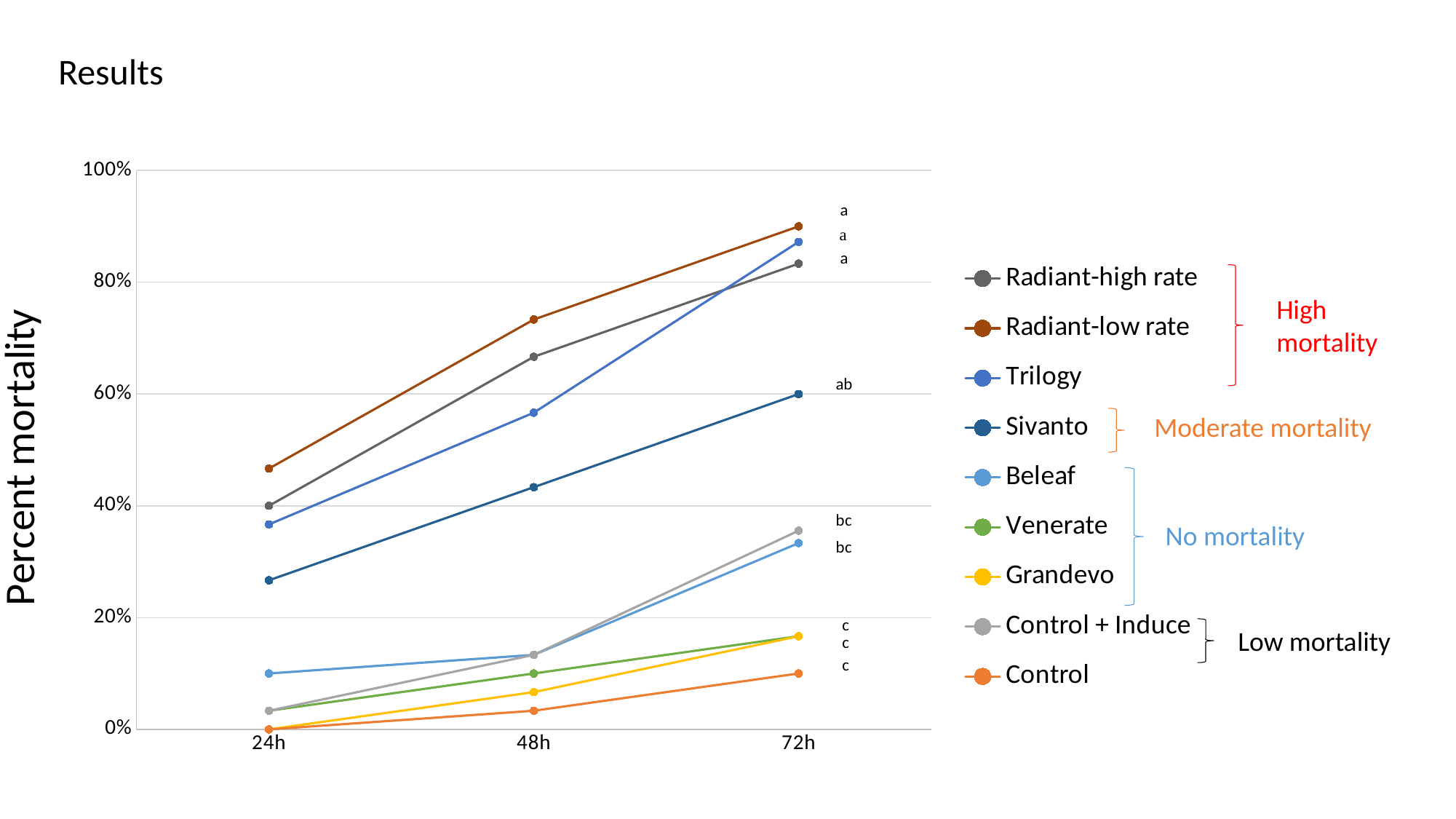
Is the value for Beleaf at 72h greater or less than 40%? less Which series has the lowest percent mortality at 72h? Control Does the percent mortality for Sivanto rise or fall from 24h to 72h? rise What is the percent mortality for Control at 24h? 0% How many series does the legend list? 9 What is the percent mortality for Sivanto at 72h? 60% What kind of chart is shown on the slide? line chart Is the value for Radiant-low rate at 48h greater or less than 60%? greater Which series has the highest percent mortality at 72h? Radiant-low rate How many time points are plotted along the x axis? 3 At 72h, which is larger: Trilogy or Radiant-high rate? Trilogy What is the percent mortality for Radiant-high rate at 24h? 40%